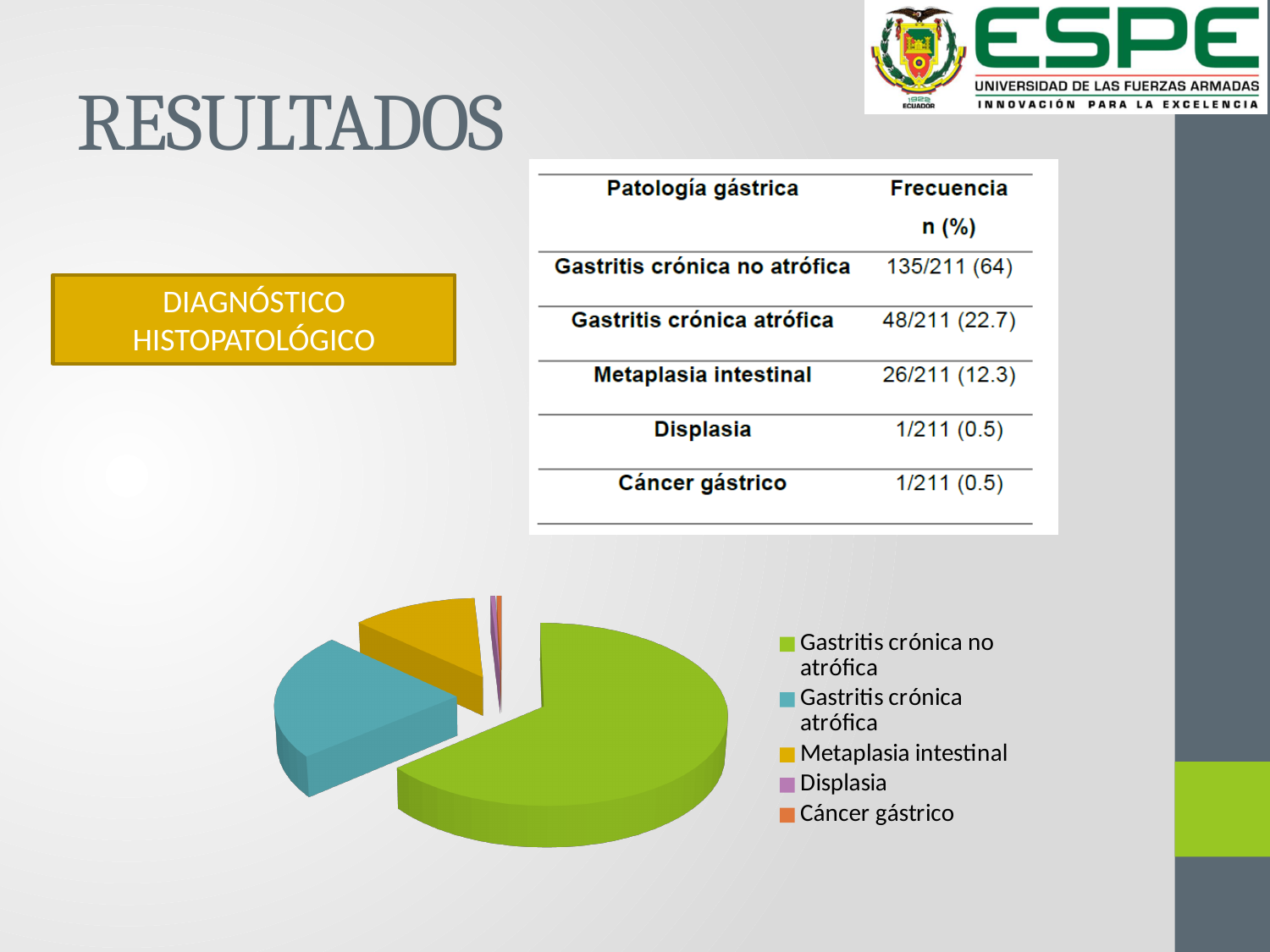
What kind of chart is shown on the slide? pie chart How many entries does the pie chart's legend list? 5 Which slice is larger in the pie chart, Gastritis crónica no atrófica or Gastritis crónica atrófica? Gastritis crónica no atrófica Which category does the blue slice of the pie chart represent? Gastritis crónica atrófica According to the table on the slide, what percentage share does Gastritis crónica atrófica have? 22.7 How many slices does the pie chart have? 5 According to the table on the slide, what percentage share does Gastritis crónica no atrófica have? 64 What colour is the Gastritis crónica no atrófica slice in the pie chart? green According to the table on the slide, what is the frequency n (%) for Displasia? 1/211 (0.5) Which category has the largest slice in the pie chart? Gastritis crónica no atrófica According to the table on the slide, what percentage share does Metaplasia intestinal have? 12.3 Which slice is larger in the pie chart, Gastritis crónica atrófica or Metaplasia intestinal? Gastritis crónica atrófica